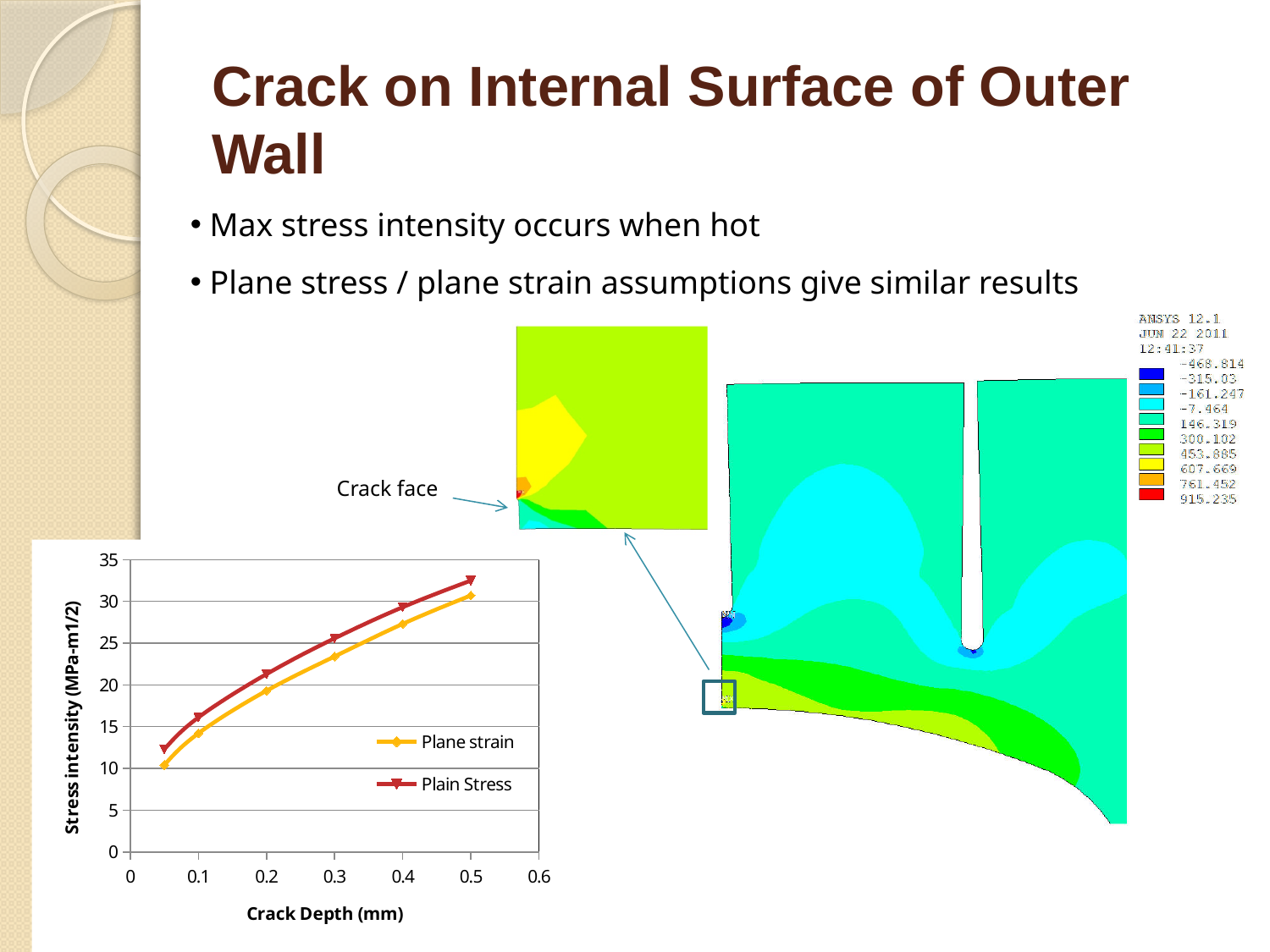
Does stress intensity rise or fall as crack depth increases? rise What kind of chart is shown on the slide? line chart Is the Plane strain value at a crack depth of 0.05 mm greater or less than 15? less Is the Plane strain value at a crack depth of 0.3 mm greater or less than 25? less At which crack depth is the stress intensity highest for the Plain Stress series? 0.5 What is the x-axis title of the chart? Crack Depth (mm) What are the two series named in the chart legend? Plane strain and Plain Stress Which series has the higher stress intensity at a crack depth of 0.5 mm, Plane strain or Plain Stress? Plain Stress How many data points are plotted for the Plane strain series? 6 Is the Plain Stress value at a crack depth of 0.5 mm greater or less than 30? greater How many series does the chart legend list? 2